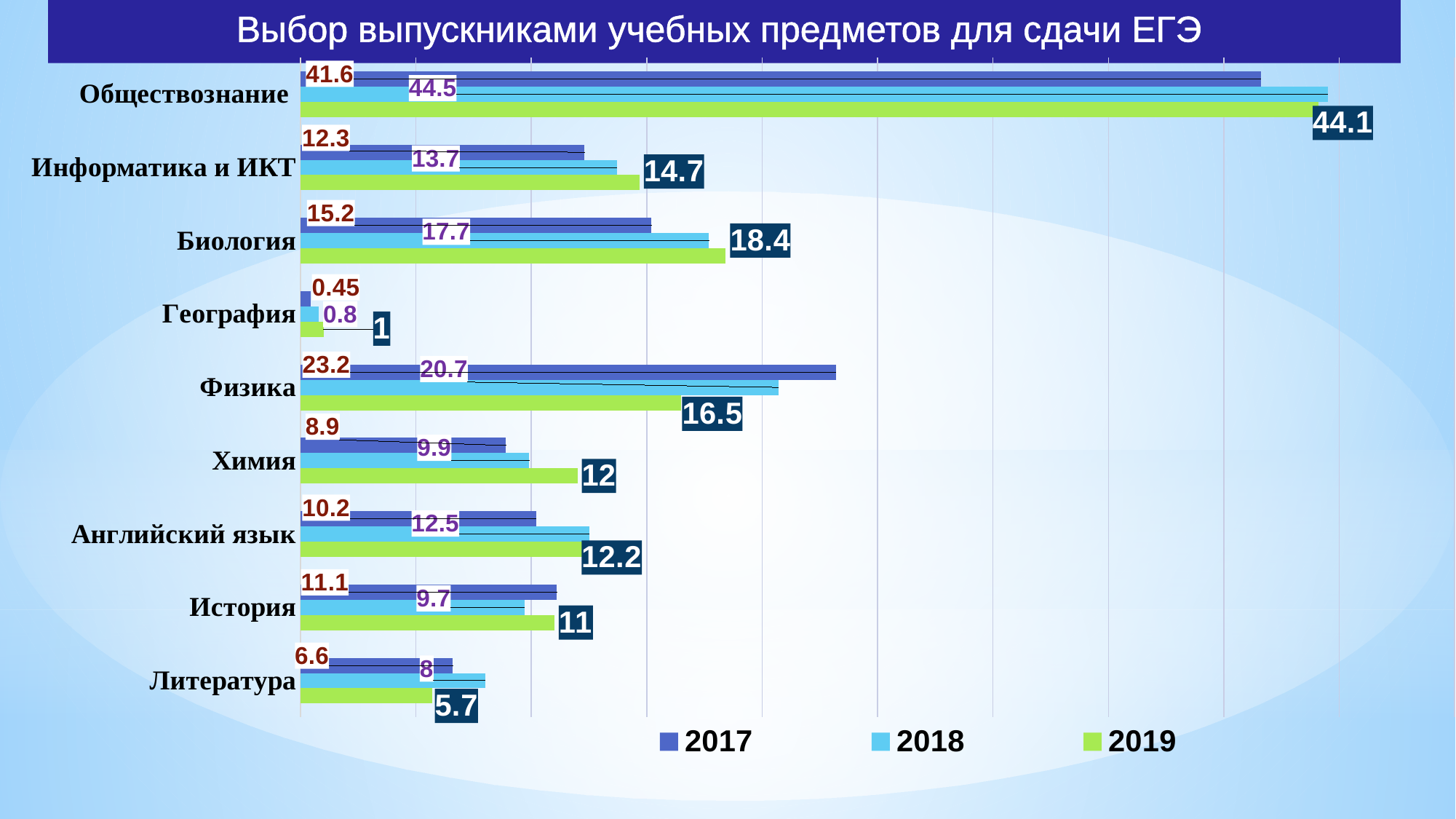
What type of chart is shown on the slide? bar chart How many subjects (categories) are shown in the chart? 9 Which is larger for Физика: the 2017 value or the 2019 value? 2017 How many series does the legend list? 3 What is the title of the chart? Выбор выпускниками учебных предметов для сдачи ЕГЭ Do the values for Химия rise or fall from 2017 to 2019? rise What is the difference between the 2018 and 2017 values for Информатика и ИКТ? 1.4 Which subject has the highest 2018 value? Обществознание What is the 2018 value for Биология? 17.7 What is the 2019 value for Обществознание? 44.1 What is the 2017 value for Физика? 23.2 Which subject has the lowest 2019 value? География